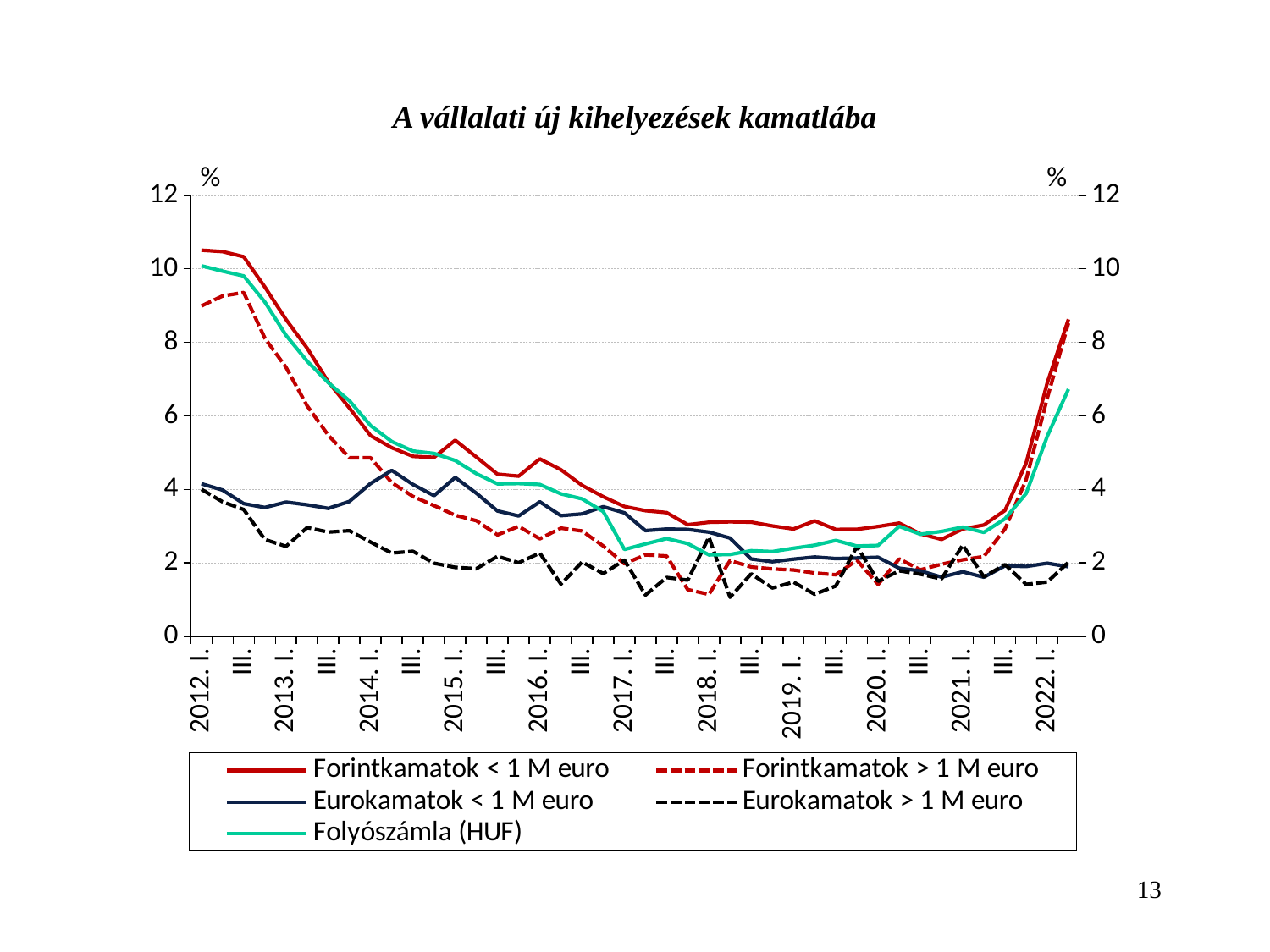
What is the title of the chart? A vállalati új kihelyezések kamatlába Which series has the highest value at 2012. I.? Forintkamatok < 1 M euro Is the value for Folyószámla (HUF) at the last point of the series (2022) greater or less than 6? greater What kind of chart is shown on the slide? line chart What unit is shown on the vertical axes of the chart? % Is the value for Forintkamatok < 1 M euro at 2019. I. greater or less than 4? less Does the Forintkamatok < 1 M euro series rise or fall between 2012. I. and 2017. I.? fall How many series does the legend list? 5 Is the value for Forintkamatok < 1 M euro at 2012. I. greater or less than 10? greater At 2012. I., which is larger: Forintkamatok < 1 M euro or Eurokamatok < 1 M euro? Forintkamatok < 1 M euro Does the Forintkamatok > 1 M euro series rise or fall between 2021. III. and 2022? rise